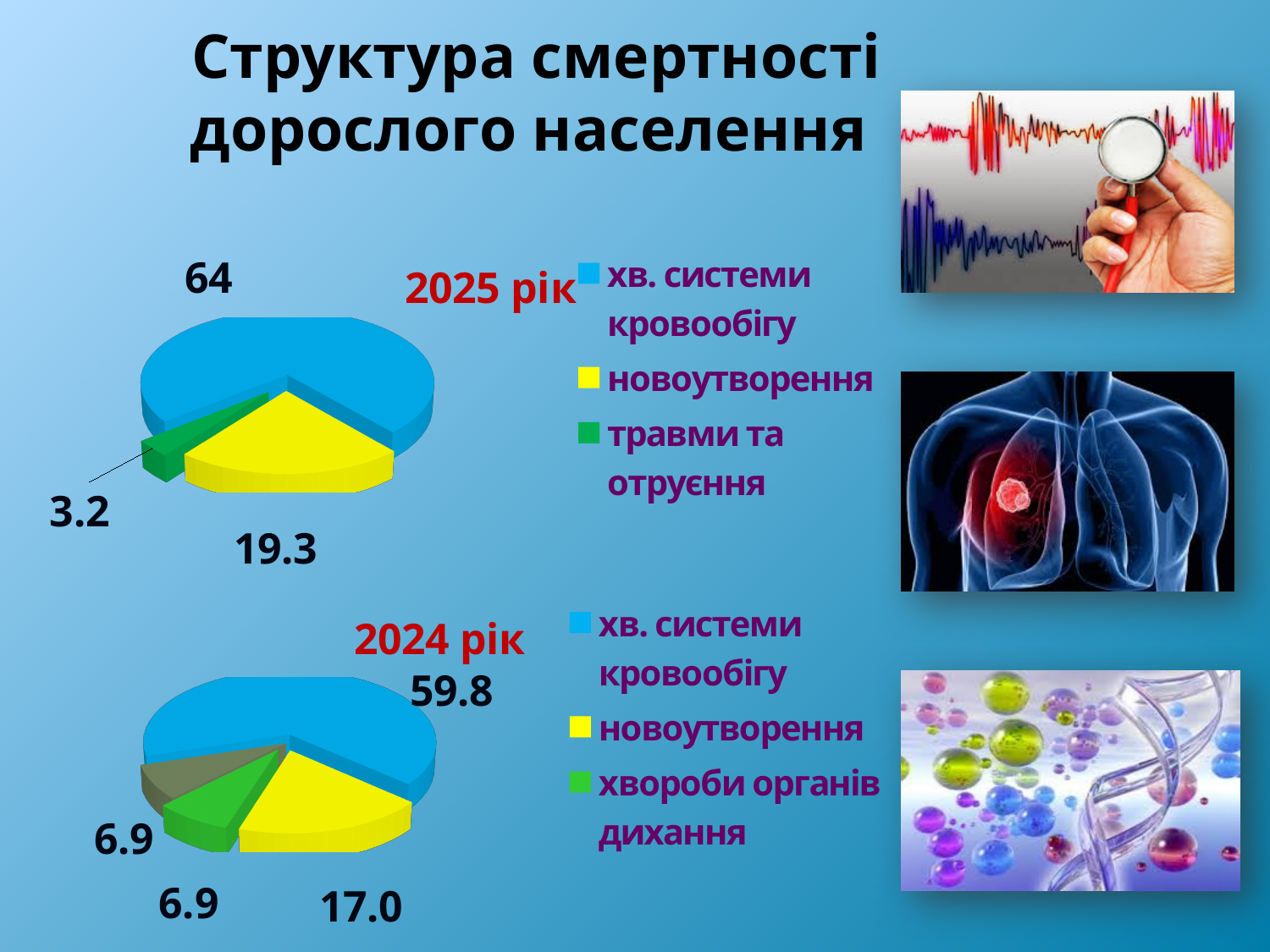
In the 2024 рік pie chart, what is the difference between the values for хв. системи кровообігу and новоутворення? 42.8 In the 2025 рік pie chart, what is the value for новоутворення? 19.3 In the 2025 рік pie chart, what is the value for травми та отруєння? 3.2 In the 2025 рік pie chart, what is the difference between the values for хв. системи кровообігу and новоутворення? 44.7 How many categories does the legend of the 2024 рік chart list? 3 In the 2025 рік pie chart, what is the value for хв. системи кровообігу? 64 In the 2024 рік pie chart, what is the value for новоутворення? 17.0 Which chart shows a larger value for хв. системи кровообігу, 2025 рік or 2024 рік? 2025 рік What type of chart is used for 2025 рік? pie chart In the 2025 рік pie chart, which category has the largest slice? хв. системи кровообігу In the 2024 рік pie chart, what is the value for хв. системи кровообігу? 59.8 In the 2025 рік pie chart, which category has the smallest slice? травми та отруєння